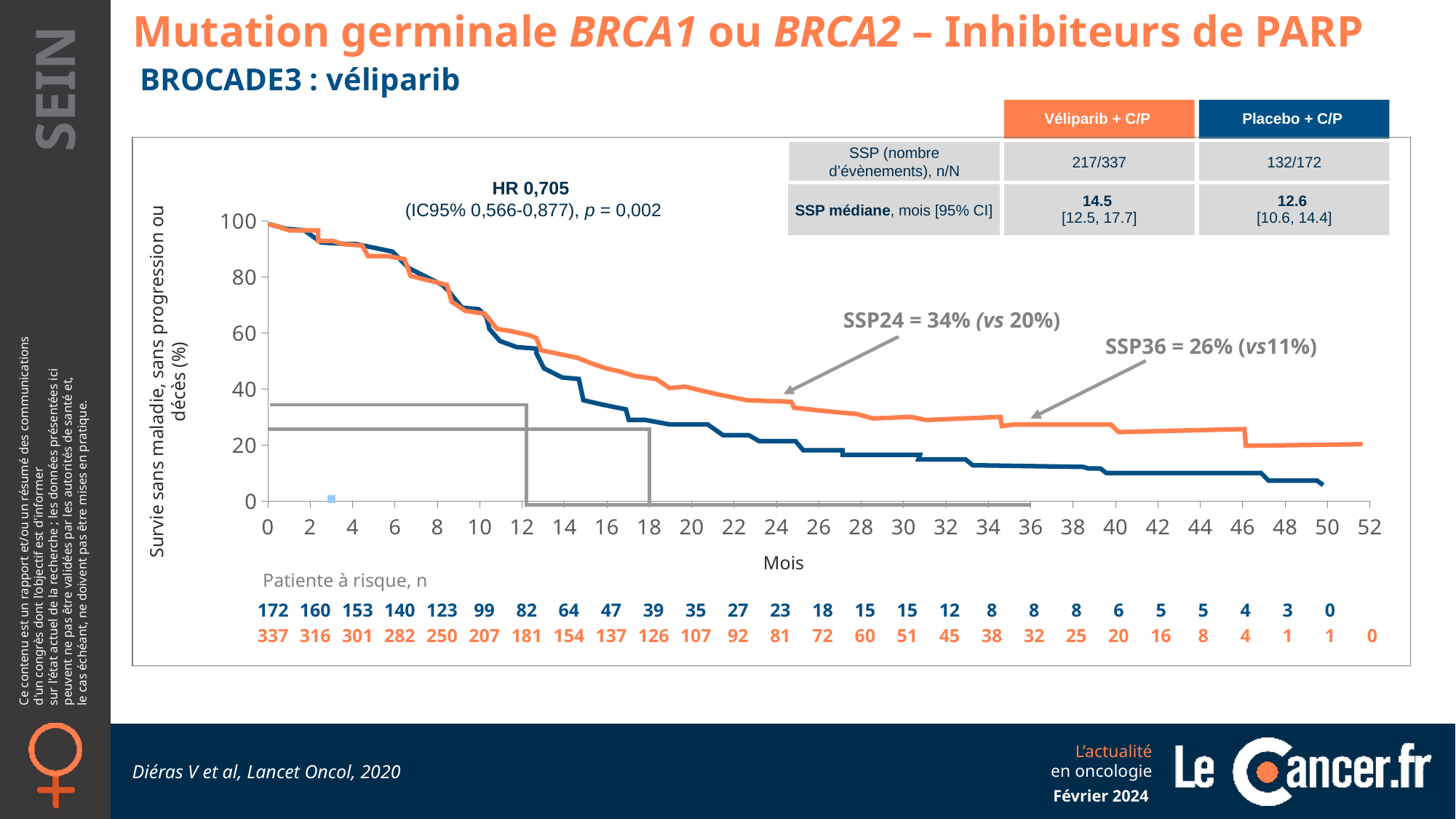
What kind of chart is shown on the slide? line chart What is the difference in SSP24 between the Véliparib + C/P arm and the Placebo + C/P arm? 14 percentage points What is the SSP24 value for the Véliparib + C/P arm? 34% What is the SSP36 value for the Placebo + C/P arm? 11% Do the survival curves rise or fall as months increase along the x axis? fall Is the Placebo + C/P curve at 20 months greater or less than 40%? less How many patients were at risk at 12 months in the Véliparib + C/P arm? 181 Which arm has the higher SSP36, Véliparib + C/P or Placebo + C/P? Véliparib + C/P What is the SSP24 value for the Placebo + C/P arm? 20% How many series (treatment arms) are plotted on the chart? 2 What is the SSP36 value for the Véliparib + C/P arm? 26% What is the median SSP in months for the Véliparib + C/P arm? 14.5